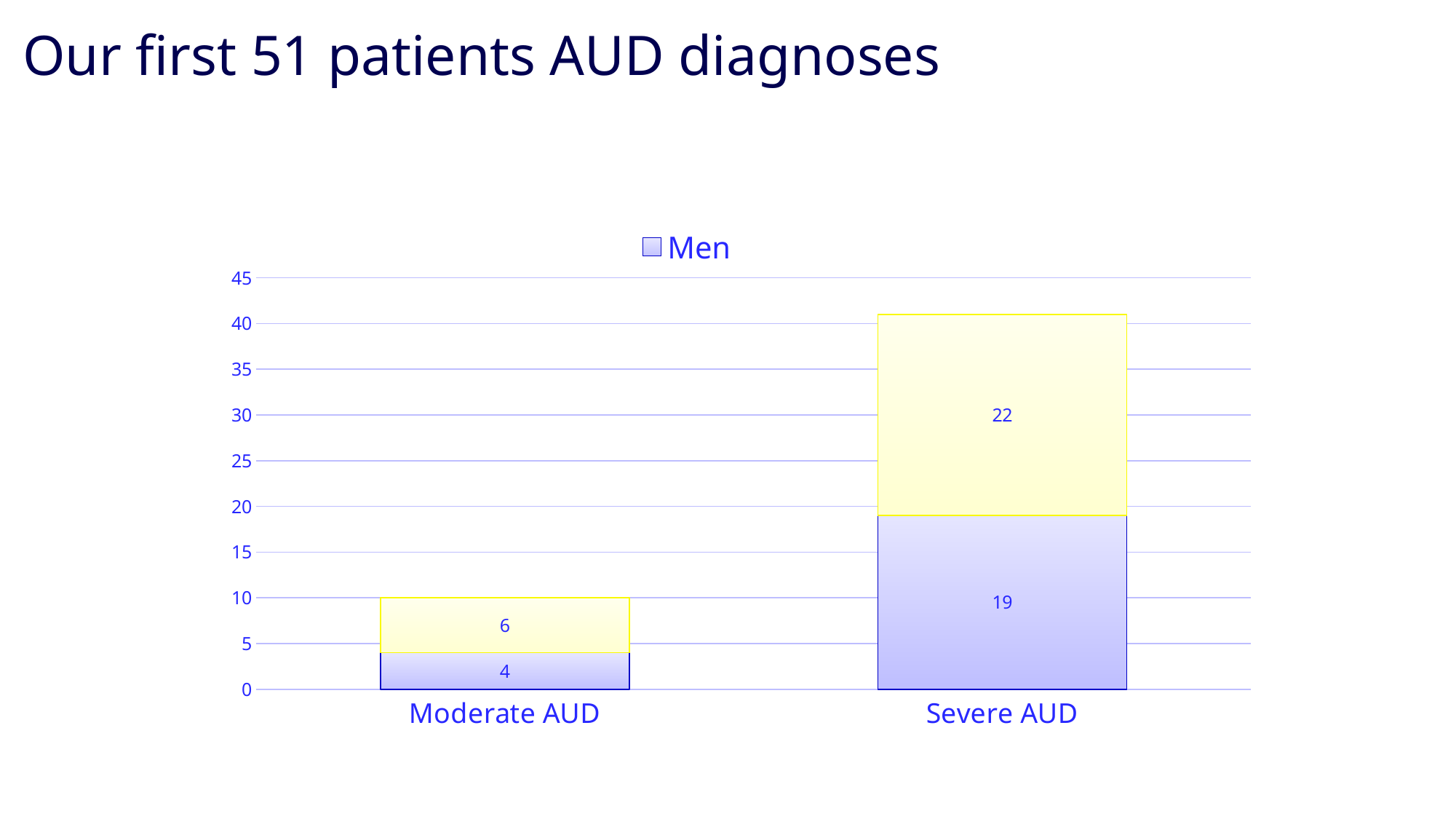
What kind of chart is shown on the slide? Stacked bar chart What is the value for Men in the Moderate AUD category? 4 How many categories are shown on the x axis? 2 What is the value of the yellow segment in the Moderate AUD bar? 6 What is the total of the stacked bar for Severe AUD? 41 How many series does the legend list? 1 What is the value for Men in the Severe AUD category? 19 What is the difference between the Men values for Severe AUD and Moderate AUD? 15 What is the value of the yellow segment in the Severe AUD bar? 22 Which category has the higher value for Men? Severe AUD Which category has the lower value for Men? Moderate AUD What is the total of the stacked bar for Moderate AUD? 10